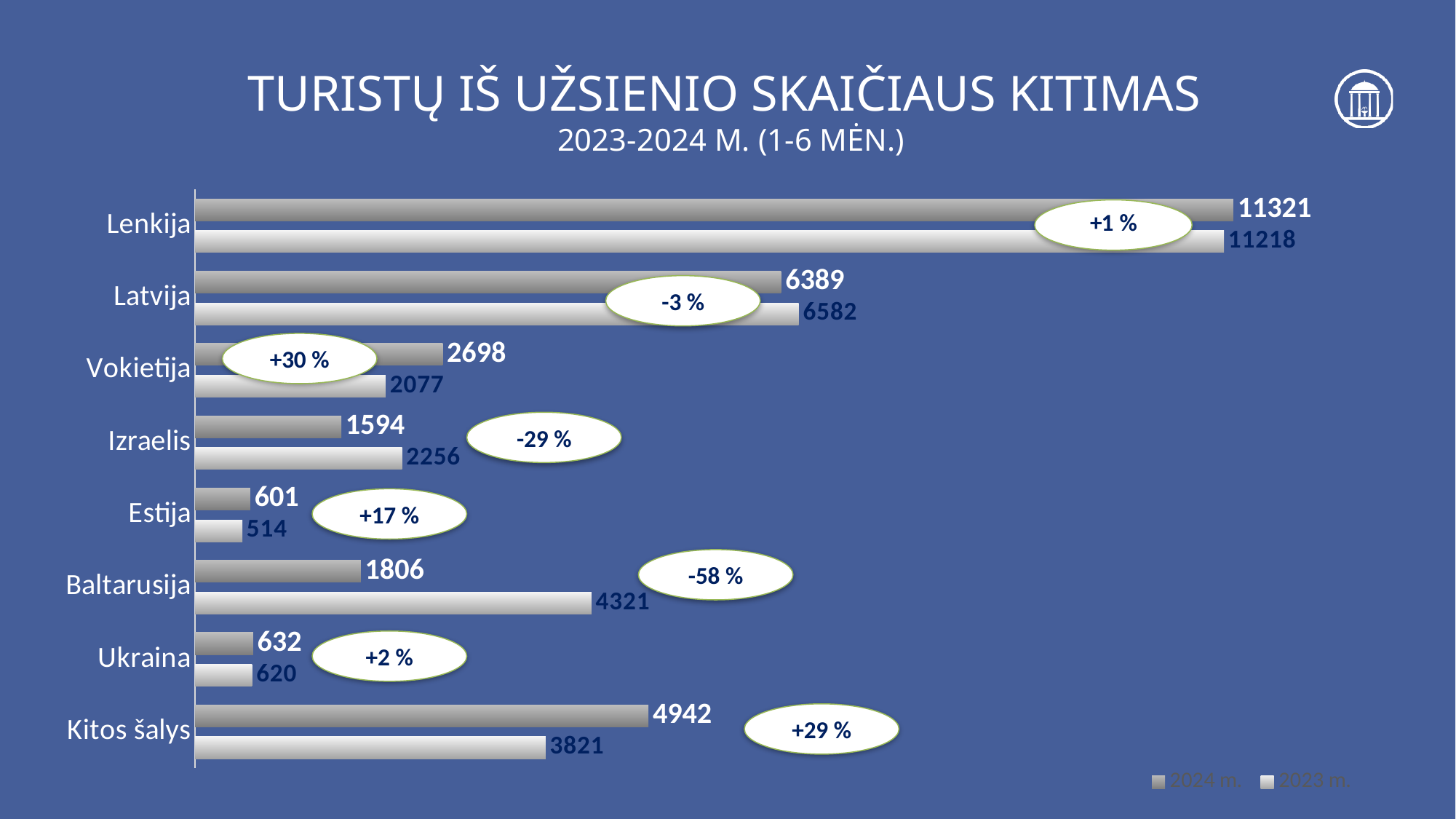
How many categories are shown on the chart? 8 Which is larger for Latvija: the 2024 m. value or the 2023 m. value? 2023 m. What is the value for Baltarusija in the 2023 m. series? 4321 What is the title of the chart? TURISTŲ IŠ UŽSIENIO SKAIČIAUS KITIMAS 2023-2024 M. (1-6 MĖN.) What kind of chart is shown on the slide? Bar chart Which category has the lowest value in the 2023 m. series? Estija Which category has the highest value in the 2024 m. series? Lenkija What is the difference between the 2024 m. and 2023 m. values for Izraelis? 662 What is the value for Vokietija in the 2024 m. series? 2698 How many series does the legend list? 2 What percentage change is shown in the oval next to Baltarusija? -58 % What is the value for Lenkija in the 2024 m. series? 11321